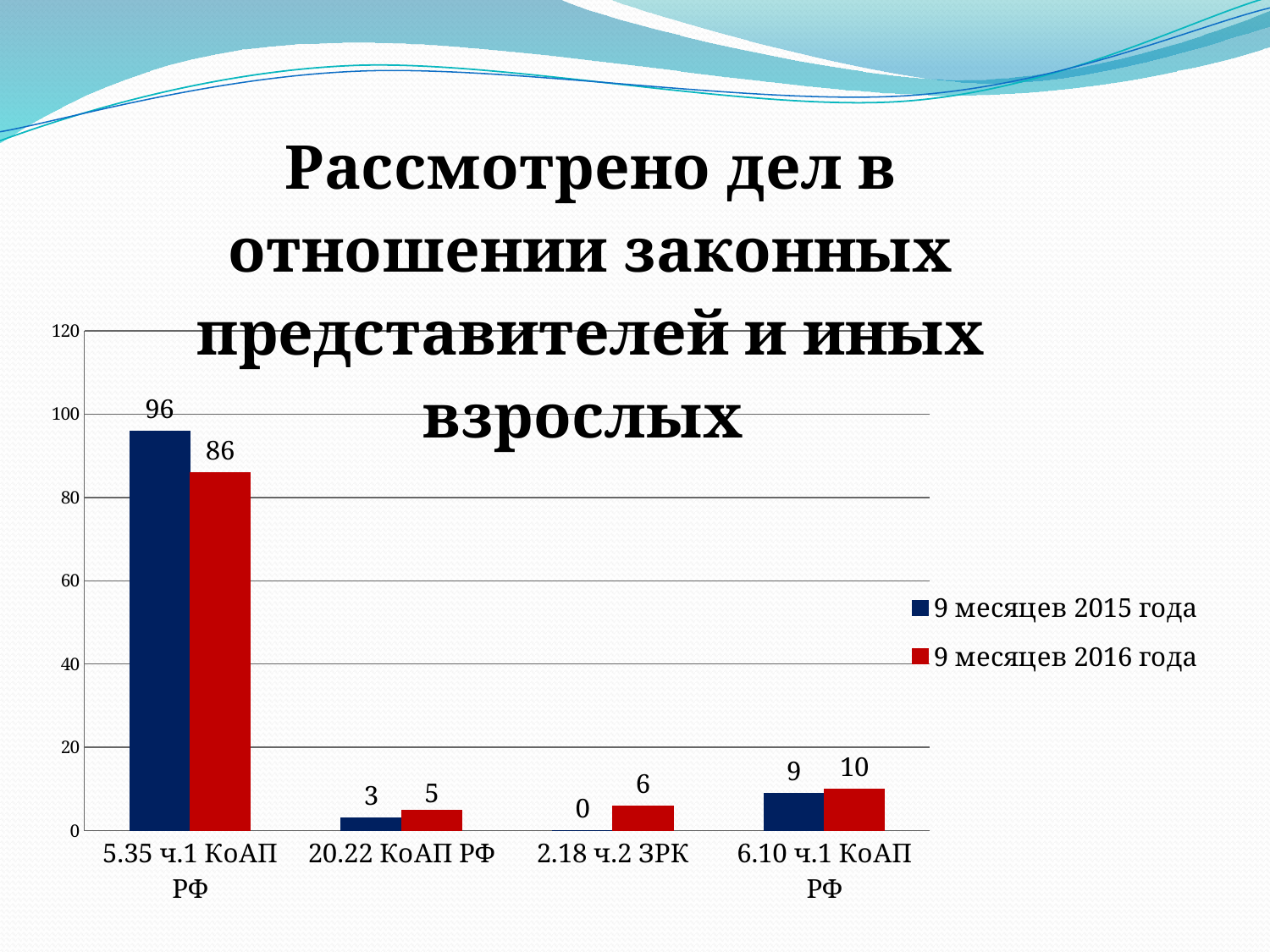
How many series does the legend list? 2 What kind of chart is shown on the slide? bar chart How many categories are shown on the x axis? 4 Which category has the highest value in the 9 месяцев 2016 года series? 5.35 ч.1 КоАП РФ For 20.22 КоАП РФ, which series has the larger value: 9 месяцев 2015 года or 9 месяцев 2016 года? 9 месяцев 2016 года What is the difference between the 9 месяцев 2015 года and 9 месяцев 2016 года values for 5.35 ч.1 КоАП РФ? 10 Is the value for 5.35 ч.1 КоАП РФ in the 9 месяцев 2016 года series greater or less than 80? greater What is the value for 5.35 ч.1 КоАП РФ in the 9 месяцев 2015 года series? 96 What is the value for 6.10 ч.1 КоАП РФ in the 9 месяцев 2015 года series? 9 What is the value for 2.18 ч.2 ЗРК in the 9 месяцев 2016 года series? 6 Which category has the lowest value in the 9 месяцев 2015 года series? 2.18 ч.2 ЗРК What is the value for 5.35 ч.1 КоАП РФ in the 9 месяцев 2016 года series? 86